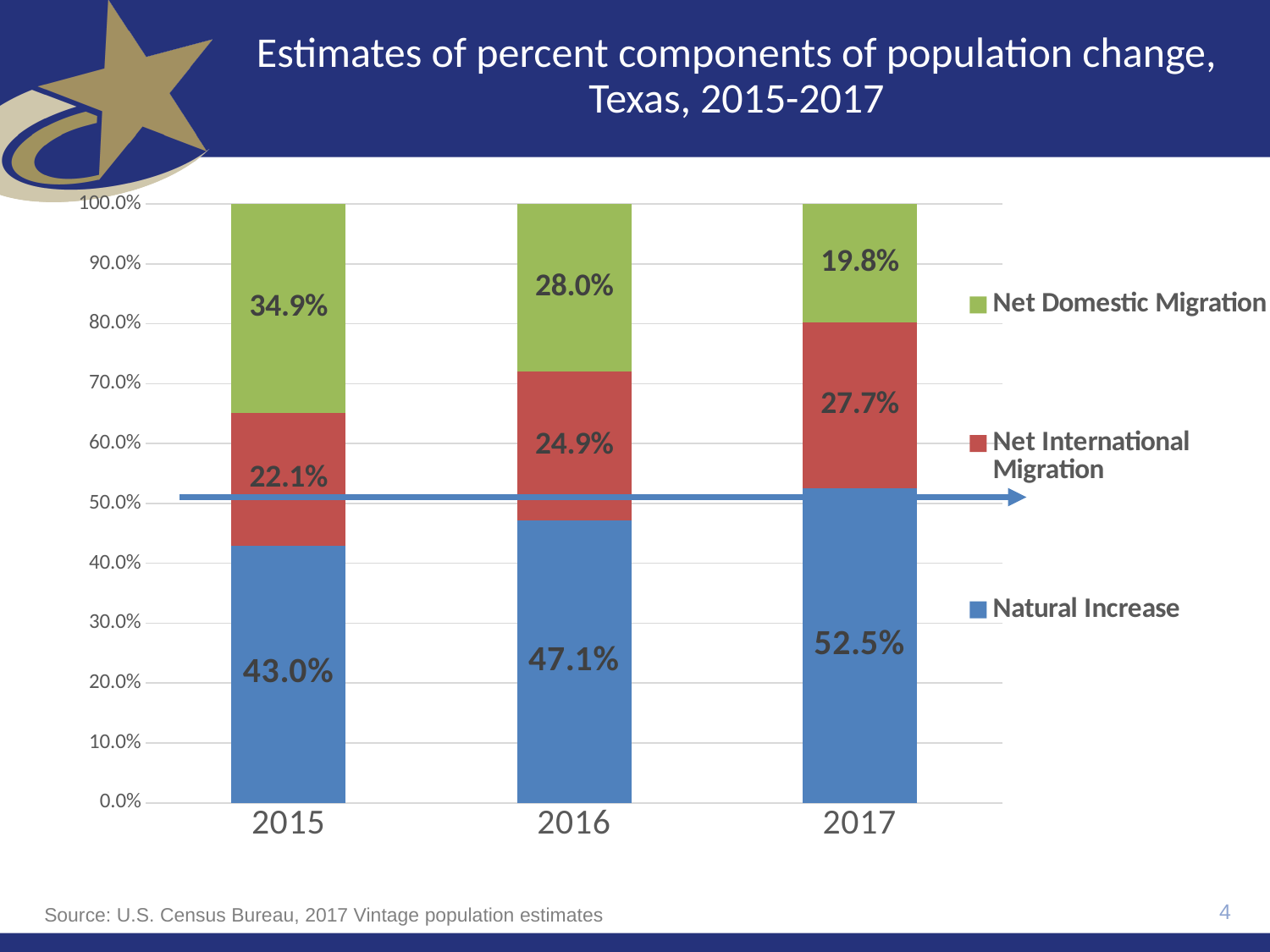
How many years are shown on the x axis? 3 How many series does the legend list? 3 What kind of chart is shown? stacked bar chart Which year has the lowest Net Domestic Migration value? 2017 What is the Net International Migration value for 2016? 24.9% What is the Net Domestic Migration value for 2015? 34.9% What is the difference between the Natural Increase values for 2017 and 2015? 9.5% Which year has the highest Natural Increase value? 2017 What is the Natural Increase value for 2017? 52.5% Is the Natural Increase value for 2016 greater or less than 50.0%? less Which is larger in 2016: Net Domestic Migration or Net International Migration? Net Domestic Migration Does the Net Domestic Migration value rise or fall from 2015 to 2017? fall